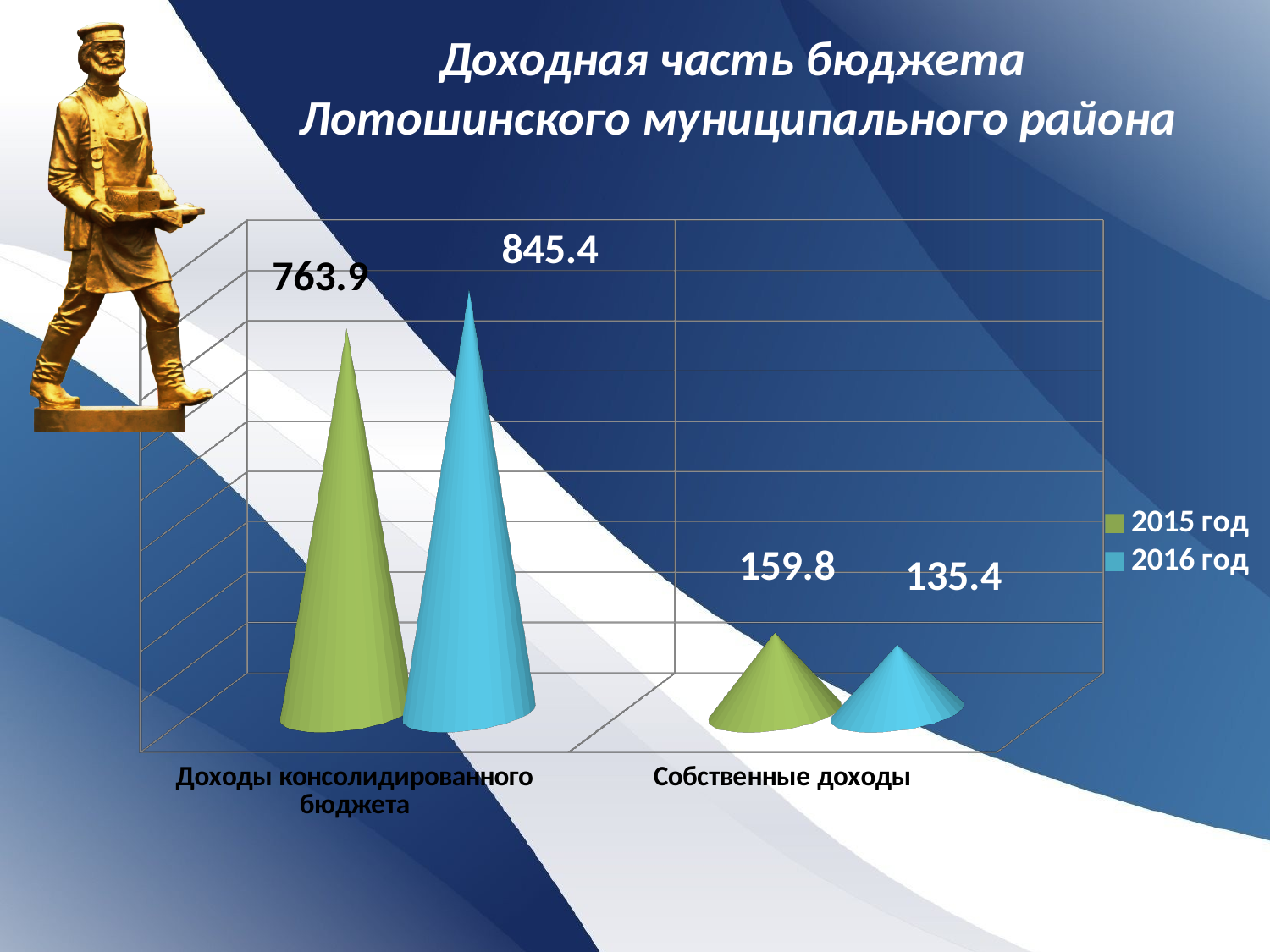
For Собственные доходы, which year has the larger value, 2015 год or 2016 год? 2015 год What is the difference between the 2016 год and 2015 год values for Доходы консолидированного бюджета? 81.5 What is the value for 2016 год for Доходы консолидированного бюджета? 845.4 What is the difference between the 2015 год and 2016 год values for Собственные доходы? 24.4 What is the value for 2016 год for Собственные доходы? 135.4 Which category has the lowest value for 2015 год? Собственные доходы What is the value for 2015 год for Собственные доходы? 159.8 Which category has the highest value for 2016 год? Доходы консолидированного бюджета What kind of chart is shown on the slide? Bar chart How many series does the legend list? 2 What is the value for 2015 год for Доходы консолидированного бюджета? 763.9 How many categories are shown on the x axis? 2